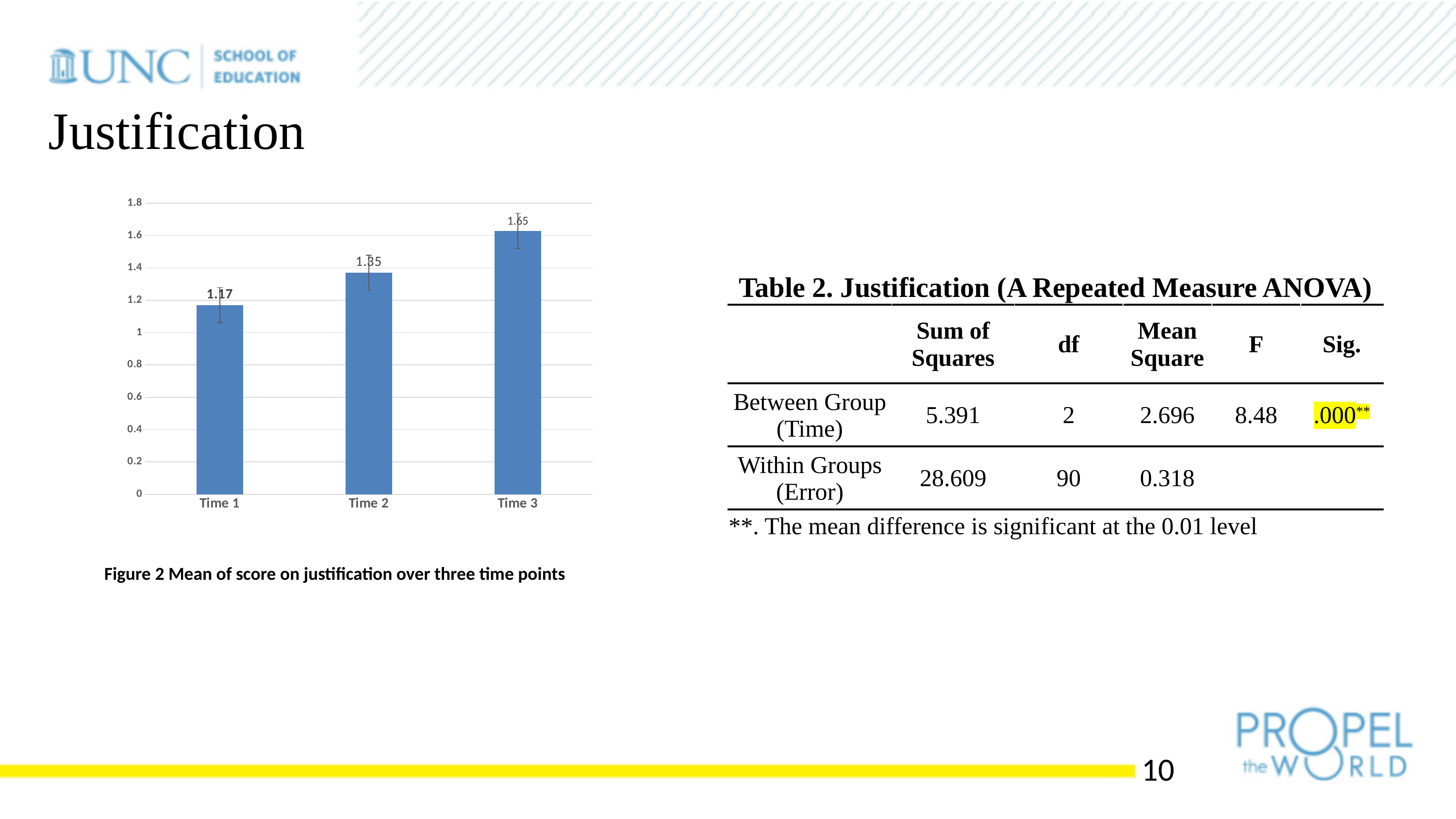
Do the mean justification scores rise or fall from Time 1 to Time 3 in the bar chart? rise How many time points are plotted in the bar chart? 3 Is the value for Time 2 in the bar chart greater or less than 1.2? greater In the bar chart, is the mean score higher at Time 2 or at Time 1? Time 2 Is the value for Time 3 in the bar chart greater or less than 1.8? less In the bar chart, is the mean score higher at Time 3 or at Time 1? Time 3 Which time point has the lowest mean justification score in the bar chart? Time 1 What is the mean justification score at Time 1 in the bar chart? 1.17 What kind of chart is shown in Figure 2? bar chart What is the caption of the bar chart on the slide? Figure 2 Mean of score on justification over three time points Is the value for Time 1 in the bar chart greater or less than 1? greater Which time point has the highest mean justification score in the bar chart? Time 3